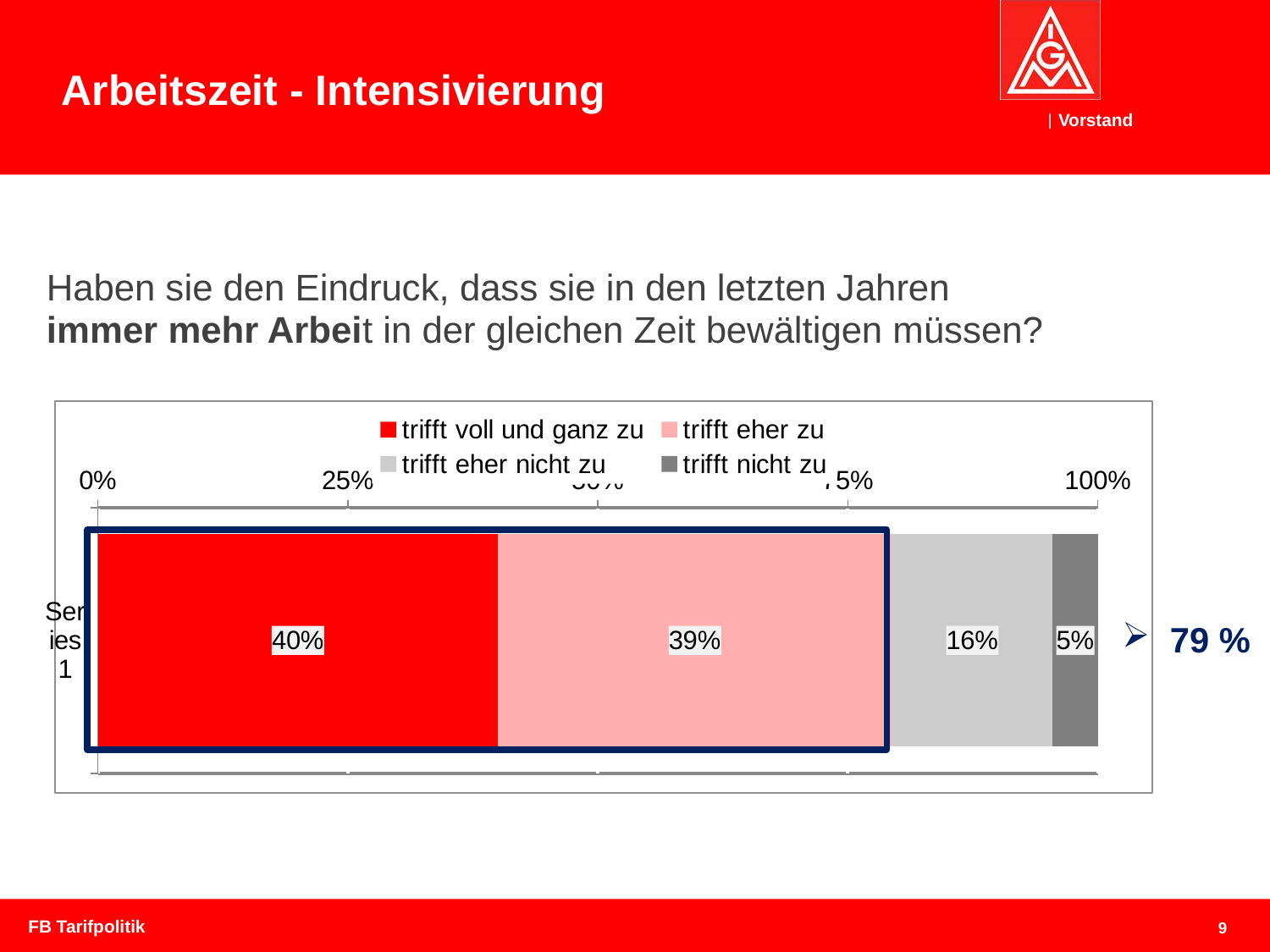
Which response category has the largest share? trifft voll und ganz zu What kind of chart is shown on the slide? Stacked bar chart What percentage of respondents answered "trifft eher nicht zu"? 16% What percentage of respondents answered "trifft voll und ganz zu"? 40% How many series does the legend list? 4 Which response category has the smallest share? trifft nicht zu What colour is used for the "trifft voll und ganz zu" segment? Red What is the combined share of "trifft voll und ganz zu" and "trifft eher zu"? 79% What is the difference between the shares for "trifft eher nicht zu" and "trifft nicht zu"? 11% What percentage of respondents answered "trifft nicht zu"? 5% What percentage of respondents answered "trifft eher zu"? 39% Which is larger, the share for "trifft eher zu" or the share for "trifft eher nicht zu"? trifft eher zu